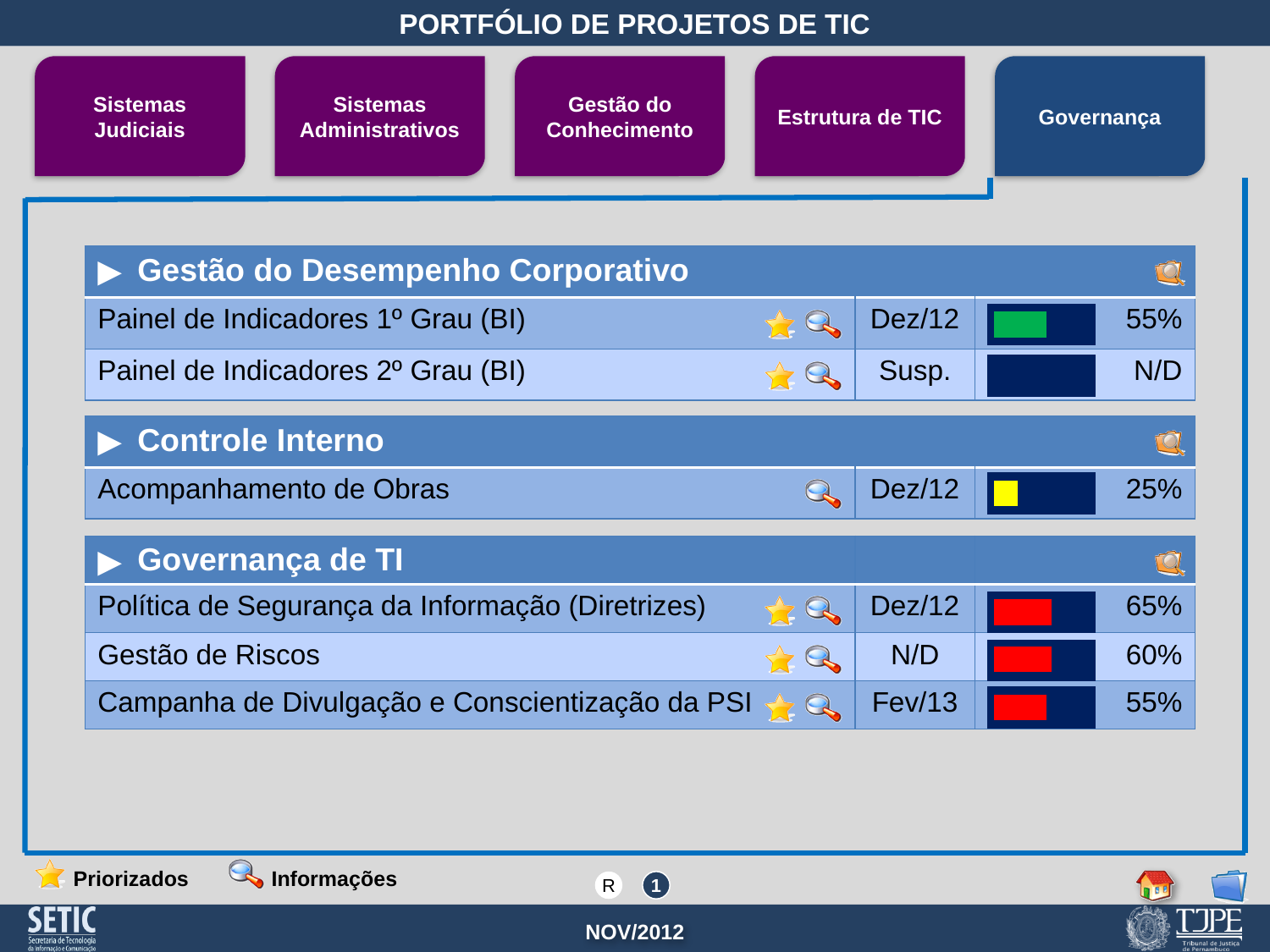
Which project has the lowest completion percentage among those with a percentage shown? Acompanhamento de Obras What is the difference between the completion percentages of Política de Segurança da Informação (Diretrizes) and Gestão de Riscos? 5% What completion percentage is shown for Painel de Indicadores 1º Grau (BI)? 55% How many projects in the Governança de TI group have a progress bar? 3 What completion percentage is shown for Acompanhamento de Obras? 25% What value is shown in the percentage column for Painel de Indicadores 2º Grau (BI)? N/D What is the deadline shown for Campanha de Divulgação e Conscientização da PSI? Fev/13 What completion percentage is shown for Política de Segurança da Informação (Diretrizes)? 65% What completion percentage is shown for Gestão de Riscos? 60% Which has a higher completion percentage, Gestão de Riscos or Acompanhamento de Obras? Gestão de Riscos What completion percentage is shown for Campanha de Divulgação e Conscientização da PSI? 55% Which project has the highest completion percentage shown on the slide? Política de Segurança da Informação (Diretrizes)